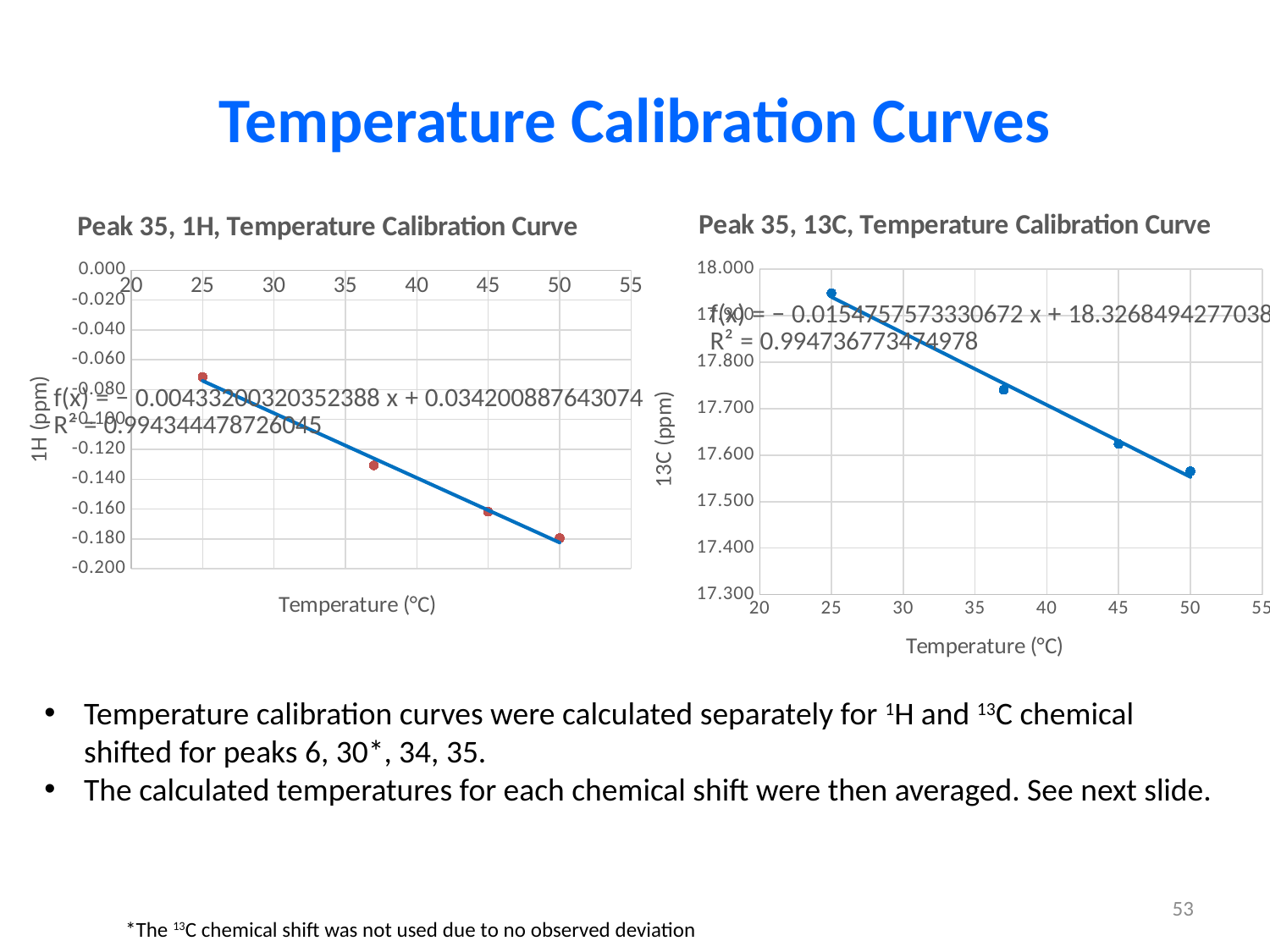
In the 'Peak 35, 13C, Temperature Calibration Curve' chart, how many data points are plotted? 4 In the 'Peak 35, 13C, Temperature Calibration Curve' chart, which temperature has the highest 13C chemical shift value? 25 In the 'Peak 35, 1H, Temperature Calibration Curve' chart, is the value at 25 °C greater or less than -0.100? greater What kind of chart is the 'Peak 35, 1H, Temperature Calibration Curve' chart? scatter chart In the 'Peak 35, 1H, Temperature Calibration Curve' chart, do the 1H chemical shift values rise or fall as temperature increases? fall In the 'Peak 35, 13C, Temperature Calibration Curve' chart, do the 13C chemical shift values rise or fall as temperature increases? fall In the 'Peak 35, 1H, Temperature Calibration Curve' chart, how many data points are plotted? 4 What is the R² value shown on the 'Peak 35, 13C, Temperature Calibration Curve' chart? 0.994736773474978 In the 'Peak 35, 13C, Temperature Calibration Curve' chart, is the value at 25 °C greater or less than 17.900? greater In the 'Peak 35, 1H, Temperature Calibration Curve' chart, is the value at 50 °C greater or less than -0.160? less What is the x-axis title of the 'Peak 35, 1H, Temperature Calibration Curve' chart? Temperature (°C)